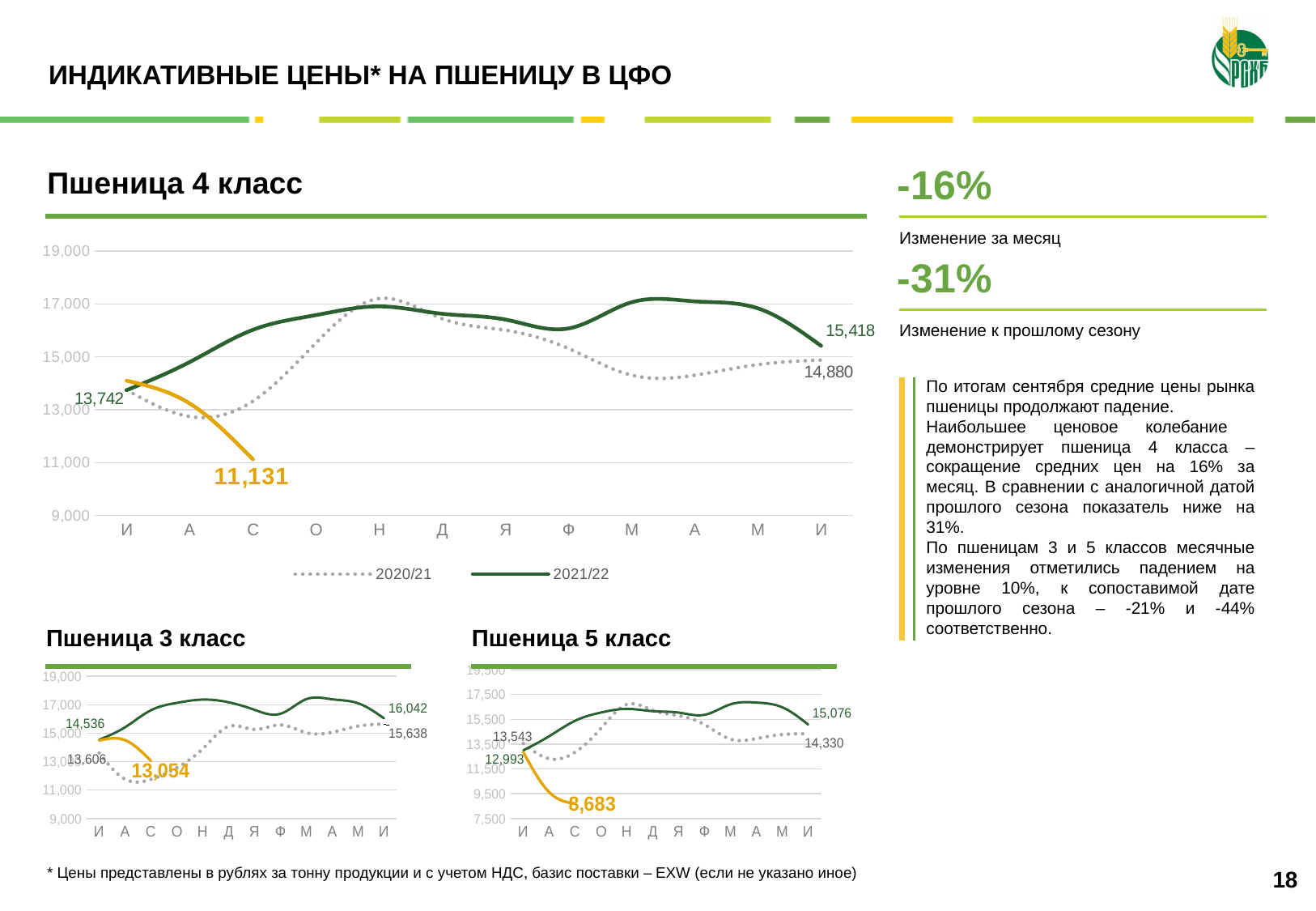
In the Пшеница 4 класс chart, what value is labelled at the end of the orange line? 11,131 In the Пшеница 4 класс chart, does the orange line rise or fall from И to С? fall In the Пшеница 5 класс chart, what is the difference between the final labelled values 15,076 and 14,330? 746 In the Пшеница 3 класс chart, what is the last labelled value of the 2021/22 (dark green) series? 16,042 In the Пшеница 4 класс chart, what is the difference between the final labelled values of 2021/22 (15,418) and 2020/21 (14,880)? 538 How many month labels are shown on the x axis of the Пшеница 4 класс chart? 12 How many series does the legend of the Пшеница 4 класс chart list? 2 In the Пшеница 4 класс chart, what is the last labelled value of the 2021/22 series? 15,418 In the Пшеница 4 класс chart, which series has the higher final labelled value, 2020/21 or 2021/22? 2021/22 In the Пшеница 4 класс chart, is the 2020/21 value at С greater or less than 15,000? less What type of chart is used for Пшеница 4 класс? line chart In the Пшеница 4 класс chart, what is the last labelled value of the 2020/21 series? 14,880